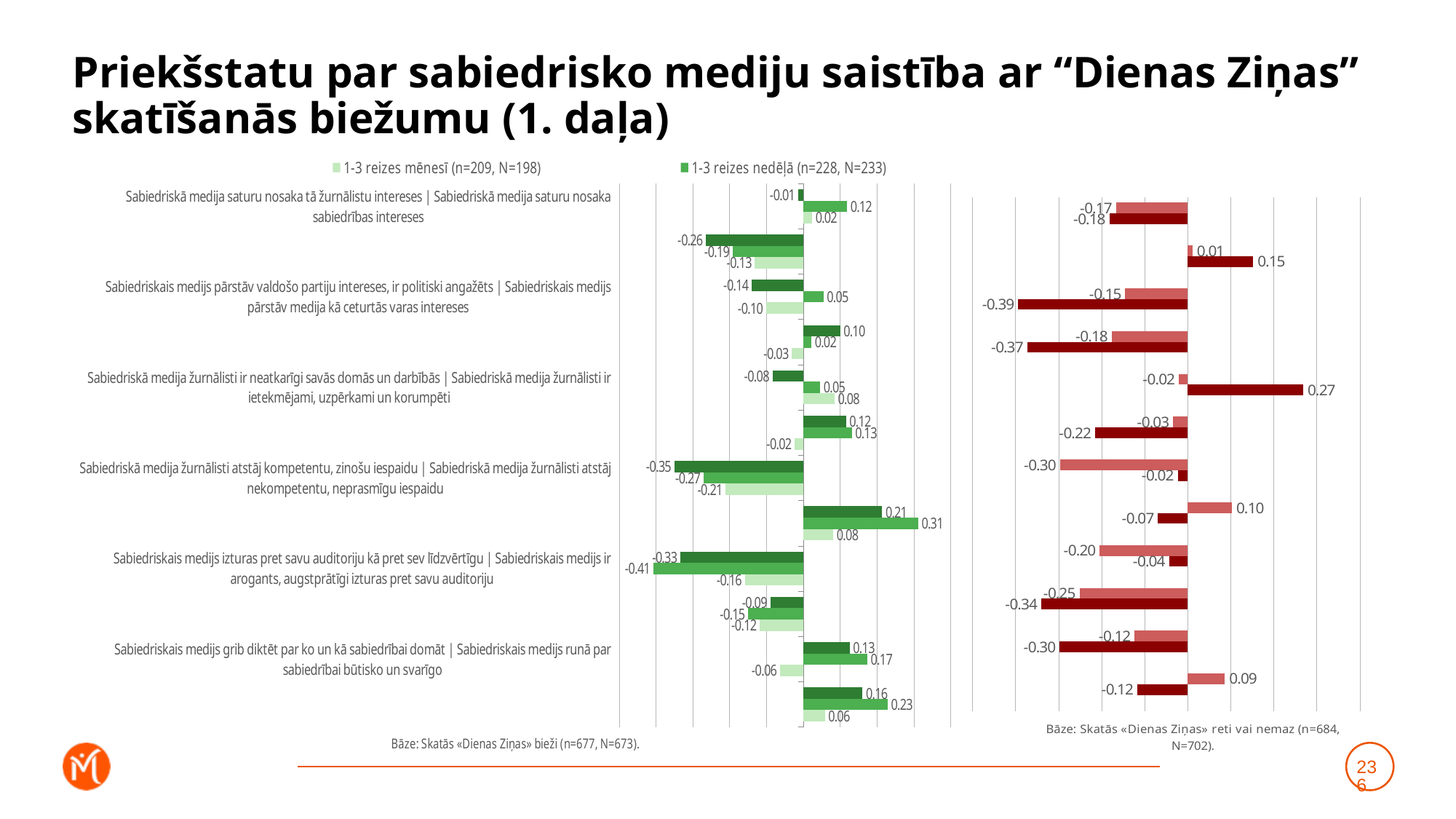
What is the first entry in the legend above the left (green) chart? 1-3 reizes mēnesī (n=209, N=198) In the left (green) chart, what is the lowest value shown by any bar? -0.41 What kind of chart is shown on the left side of the slide? bar chart How many series does the legend above the left (green) chart list? 2 In the right (red) chart, what is the difference between the highest value (0.27) and the lowest value (-0.39)? 0.66 In the left (green) chart, what is the difference between the highest value (0.31) and the lowest value (-0.41)? 0.72 In the right (red) chart, what is the highest value shown by any bar? 0.27 In the right (red) chart, is the lowest value greater or less than -0.30? less Which chart has the larger maximum bar value, the left (green) chart or the right (red) chart? the left (green) chart What colour are the bars in the right chart? red In the right (red) chart, what is the lowest value shown by any bar? -0.39 In the left (green) chart, what is the highest value shown by any bar? 0.31